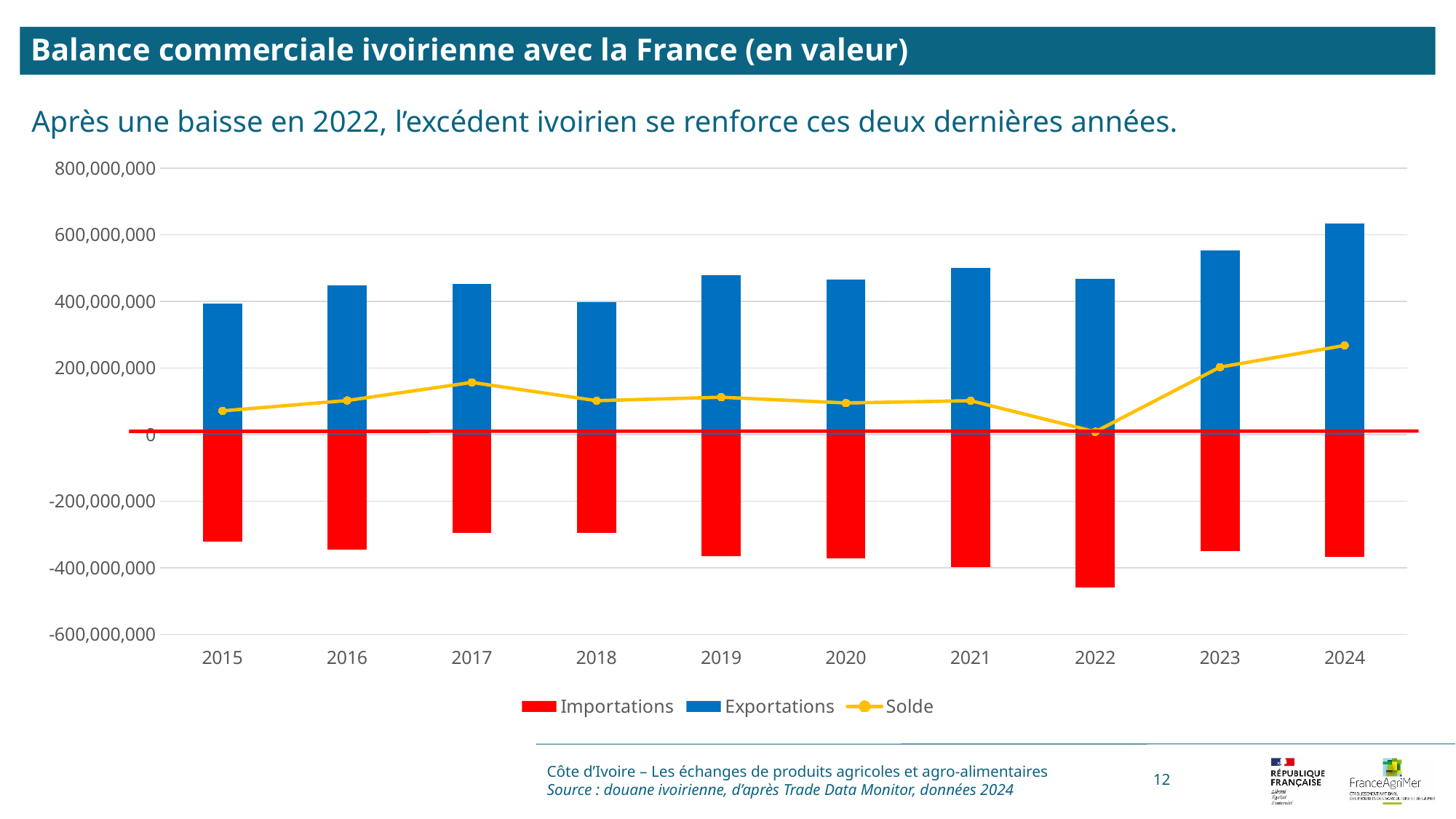
What kind of chart is shown on the slide? A bar chart combined with a line Is the Exportations value for 2024 greater or less than 600,000,000? greater How many years are shown on the x axis? 10 Which year has the larger Exportations value, 2022 or 2023? 2023 Is the Solde value for 2017 greater or less than 100,000,000? greater Does the Solde line rise or fall from 2022 to 2024? rise In which year is the Solde line at its lowest point? 2022 Is the Importations value for 2022 greater or less than -400,000,000? less How many series does the legend list? 3 In which year is the Solde line at its highest point? 2024 In which year is the Exportations bar the highest? 2024